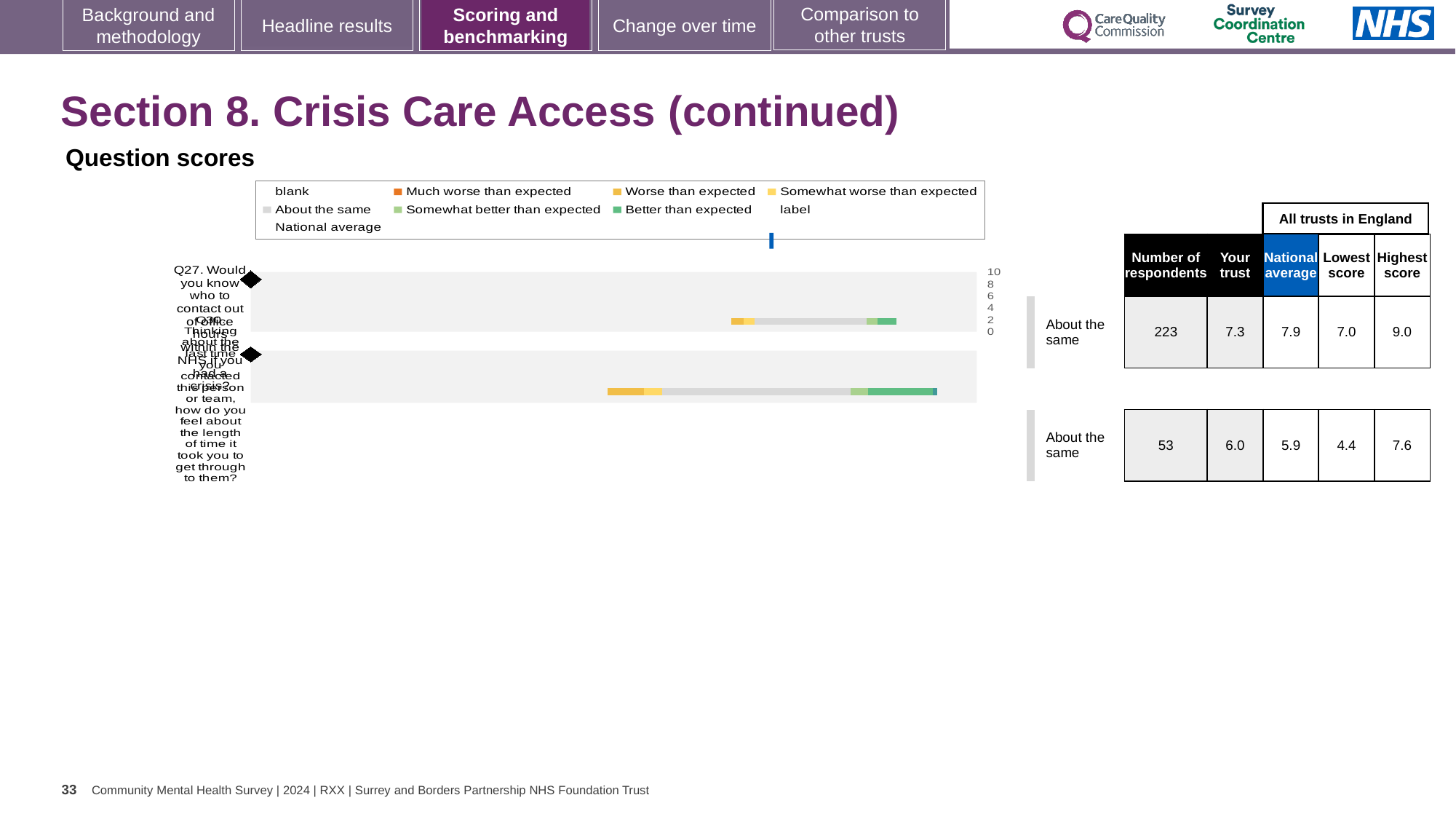
How many respondents answered Q27? 223 How many questions are plotted in the question scores chart? 2 What is the national average score for Q30? 5.9 What is the difference in the number of respondents between Q27 and Q30? 170 What kind of chart is used to show the question scores on this slide? bar chart For Q27, which is higher: the 'Your trust' score or the national average? National average What is the highest score among all trusts in England for Q27? 9.0 What is the lowest score among all trusts in England for Q30? 4.4 What is the 'Your trust' score for Q27 in the question scores table? 7.3 Which question has the higher 'Your trust' score, Q27 or Q30? Q27 What benchmark category is shown for Q30 next to the chart? About the same What is the difference between the national average and the 'Your trust' score for Q27? 0.6